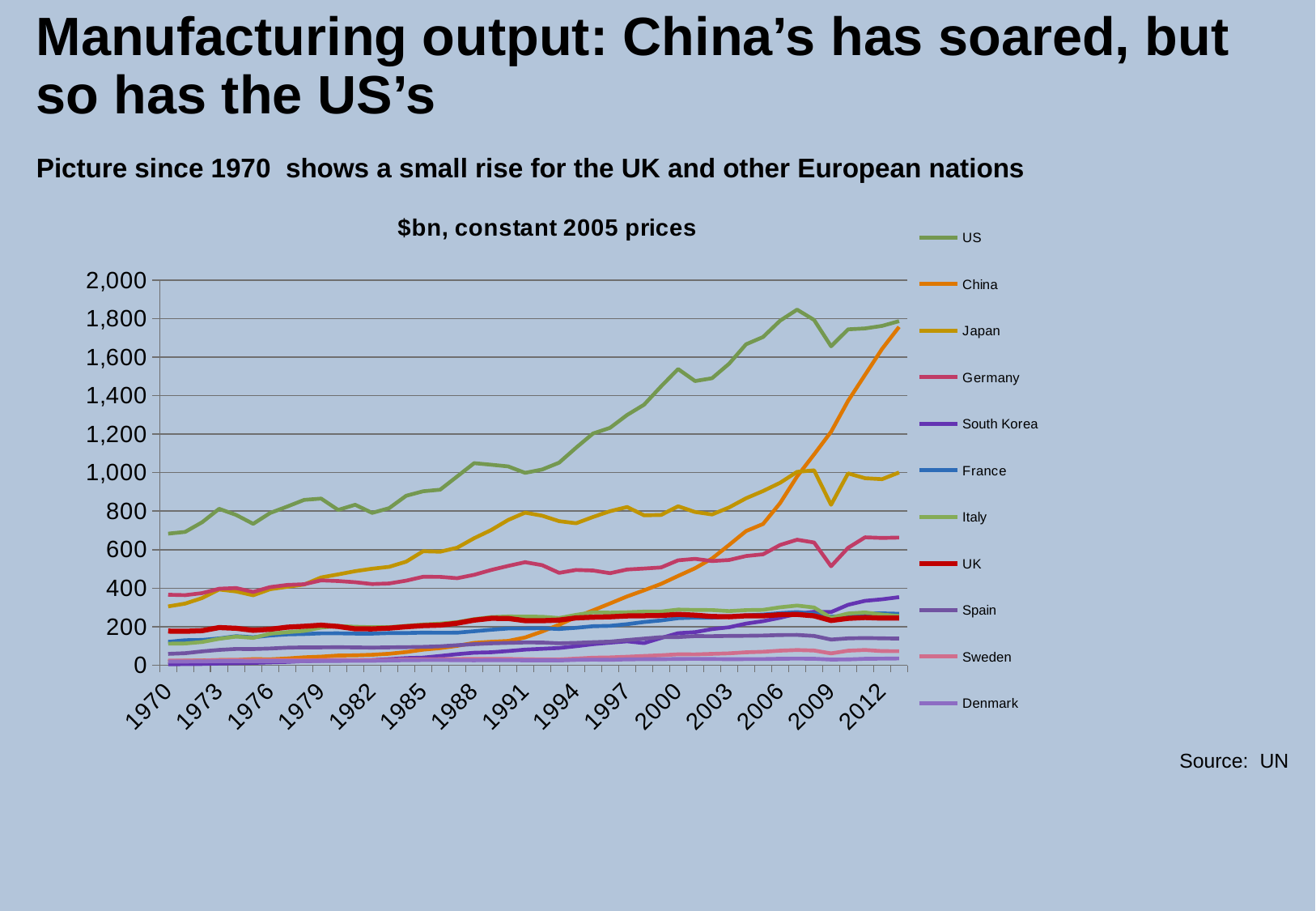
Is the value for South Korea in 1970 greater or less than 200? less Is the value for China in 2012 greater or less than 1,400? greater Is the value for Japan in 1991 greater or less than 600? greater Does the value for China rise or fall from 1970 to 2012? rise Which series has the highest value in 2012? US Which is larger in 2012, the value for China or the value for Japan? China How many series does the chart's legend list? 11 Which is larger in 2000, the value for the US or the value for Japan? US What kind of chart is shown on the slide? line chart What is the title shown above the chart's plot area? $bn, constant 2005 prices